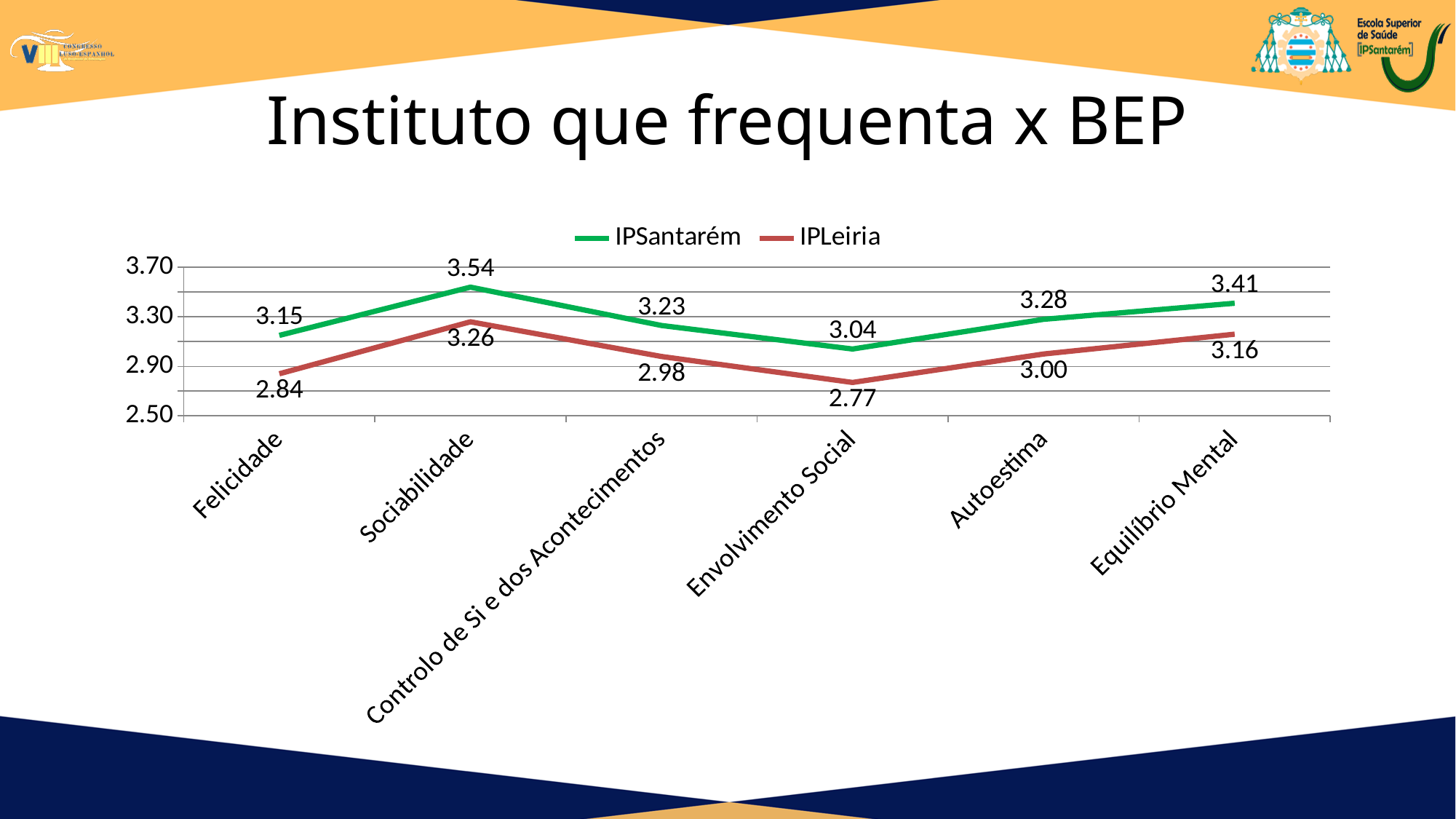
What is the difference between the IPSantarém and IPLeiria values for Felicidade? 0.31 Which category has the lowest IPSantarém value? Envolvimento Social What kind of chart is shown on the slide? Line chart What colour is the IPLeiria line? Red What is the IPLeiria value for Envolvimento Social? 2.77 Which category has the highest IPLeiria value? Sociabilidade How many series does the legend list? 2 What is the IPSantarém value for Equilíbrio Mental? 3.41 Does the IPLeiria line rise or fall from Envolvimento Social to Equilíbrio Mental? Rise Which is larger for Autoestima, the IPSantarém value or the IPLeiria value? IPSantarém How many categories are shown on the x axis? 6 What is the IPSantarém value for Sociabilidade? 3.54